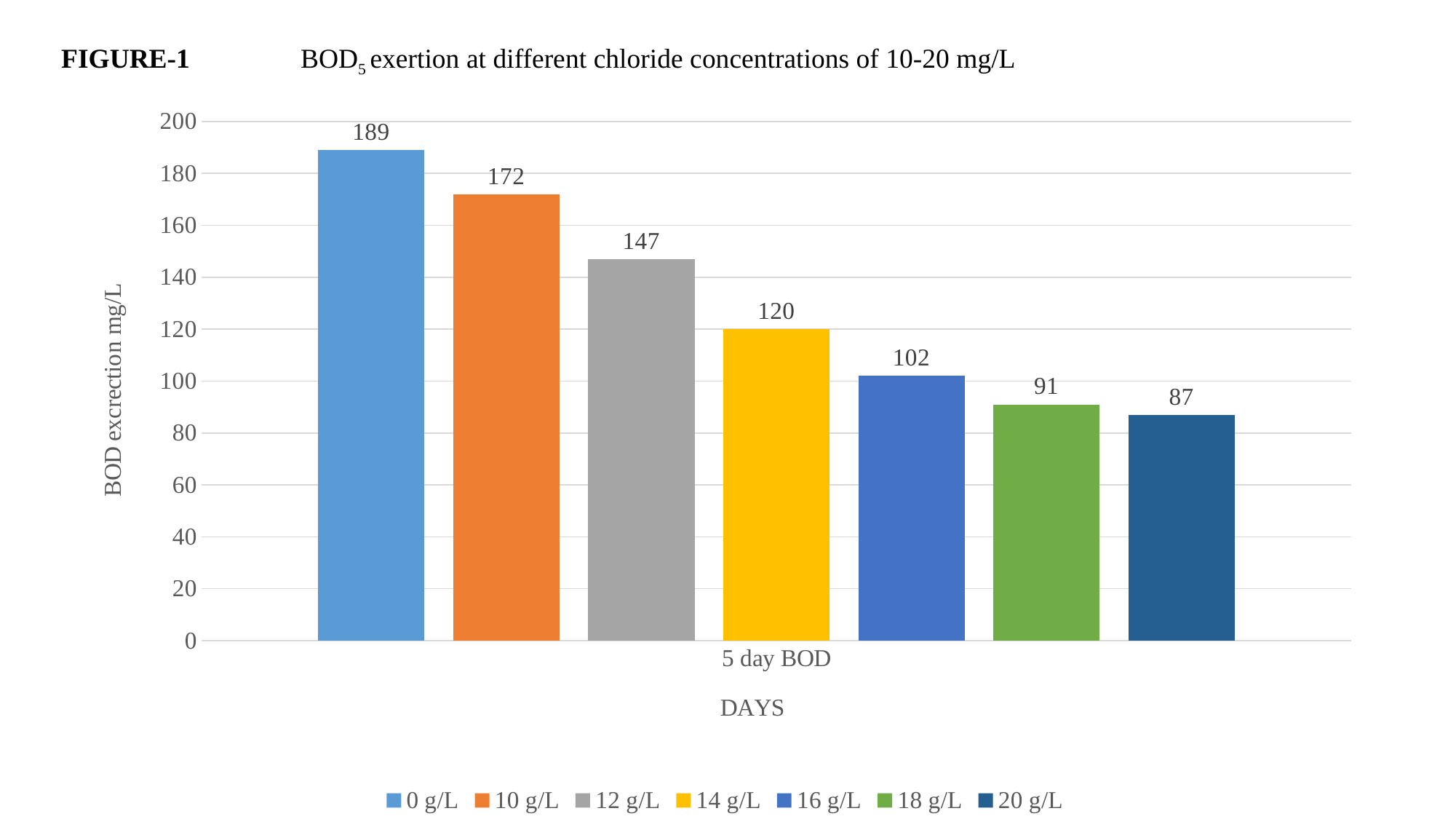
What is the BOD excretion value for 0 g/L? 189 What is the difference between the BOD excretion values for 0 g/L and 10 g/L? 17 Is the value for 12 g/L greater or less than 140? greater Which chloride concentration has the highest BOD excretion? 0 g/L Which chloride concentration has the lowest BOD excretion? 20 g/L What kind of chart is shown on the slide? Bar chart What is the label on the y axis of the chart? BOD excretion mg/L What is the BOD excretion value for 20 g/L? 87 What is the BOD excretion value for 14 g/L? 120 Which has a larger BOD excretion value, 16 g/L or 18 g/L? 16 g/L How many series does the legend list? 7 What is the difference between the BOD excretion values for 12 g/L and 16 g/L? 45